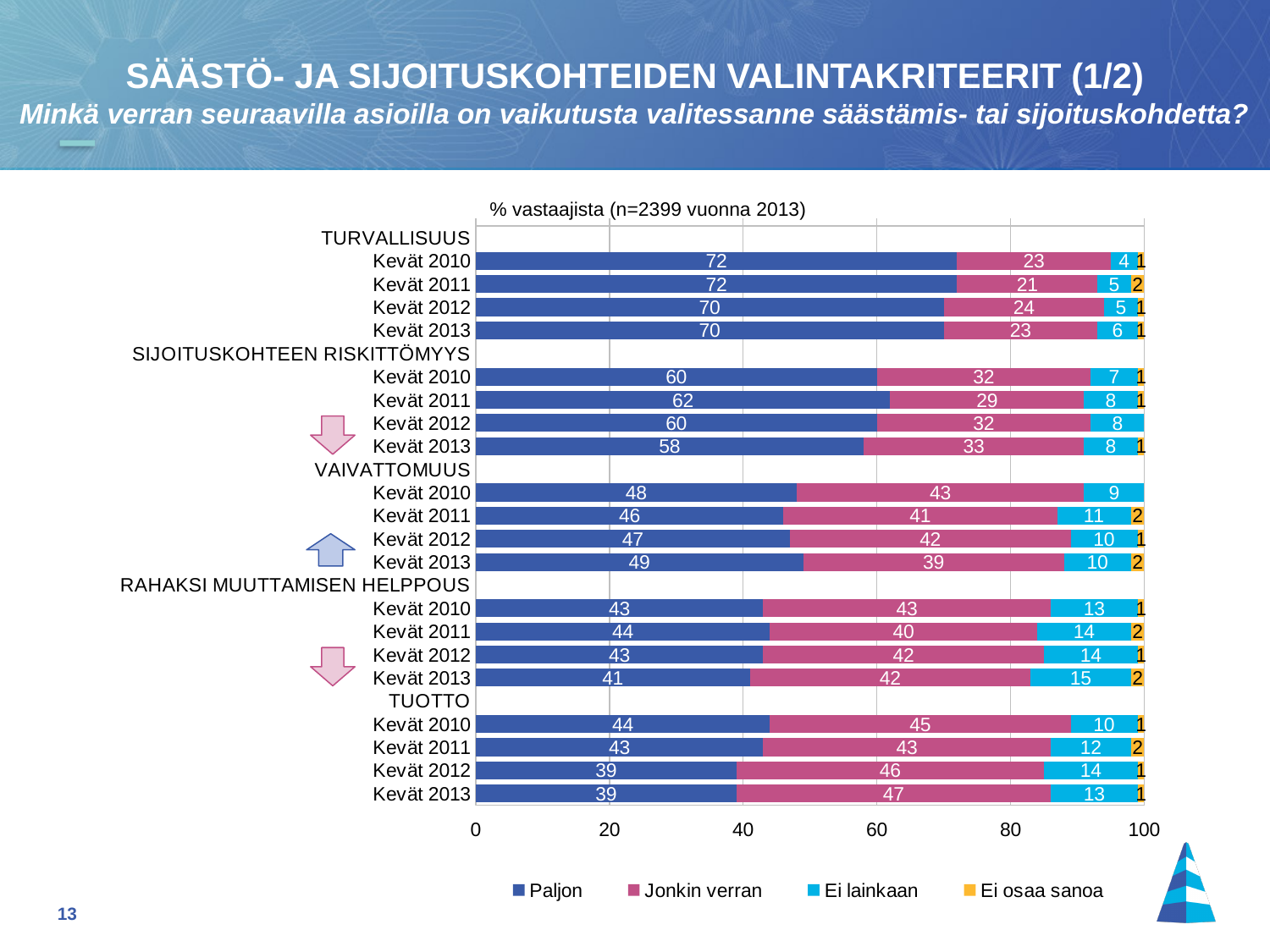
What is the difference between the 'Paljon' values for SIJOITUSKOHTEEN RISKITTÖMYYS in Kevät 2011 and Kevät 2013? 4 How many series does the legend list? 4 Does the 'Paljon' value for TUOTTO change from Kevät 2010 to Kevät 2013 by rising or falling? falling What is the 'Ei lainkaan' value for RAHAKSI MUUTTAMISEN HELPPOUS, Kevät 2013? 15 Which criterion has the lowest 'Paljon' value for Kevät 2013? TUOTTO What type of chart is shown on the slide? stacked bar chart Which criterion has the highest 'Paljon' value for Kevät 2013? TURVALLISUUS What is the 'Jonkin verran' value for SIJOITUSKOHTEEN RISKITTÖMYYS, Kevät 2013? 33 What is the 'Paljon' value for TURVALLISUUS, Kevät 2010? 72 What is the 'Paljon' value for TUOTTO, Kevät 2012? 39 What is the subtitle text shown above the chart? % vastaajista (n=2399 vuonna 2013) Which is larger: the 'Jonkin verran' value for VAIVATTOMUUS Kevät 2010 or for TUOTTO Kevät 2010? TUOTTO Kevät 2010